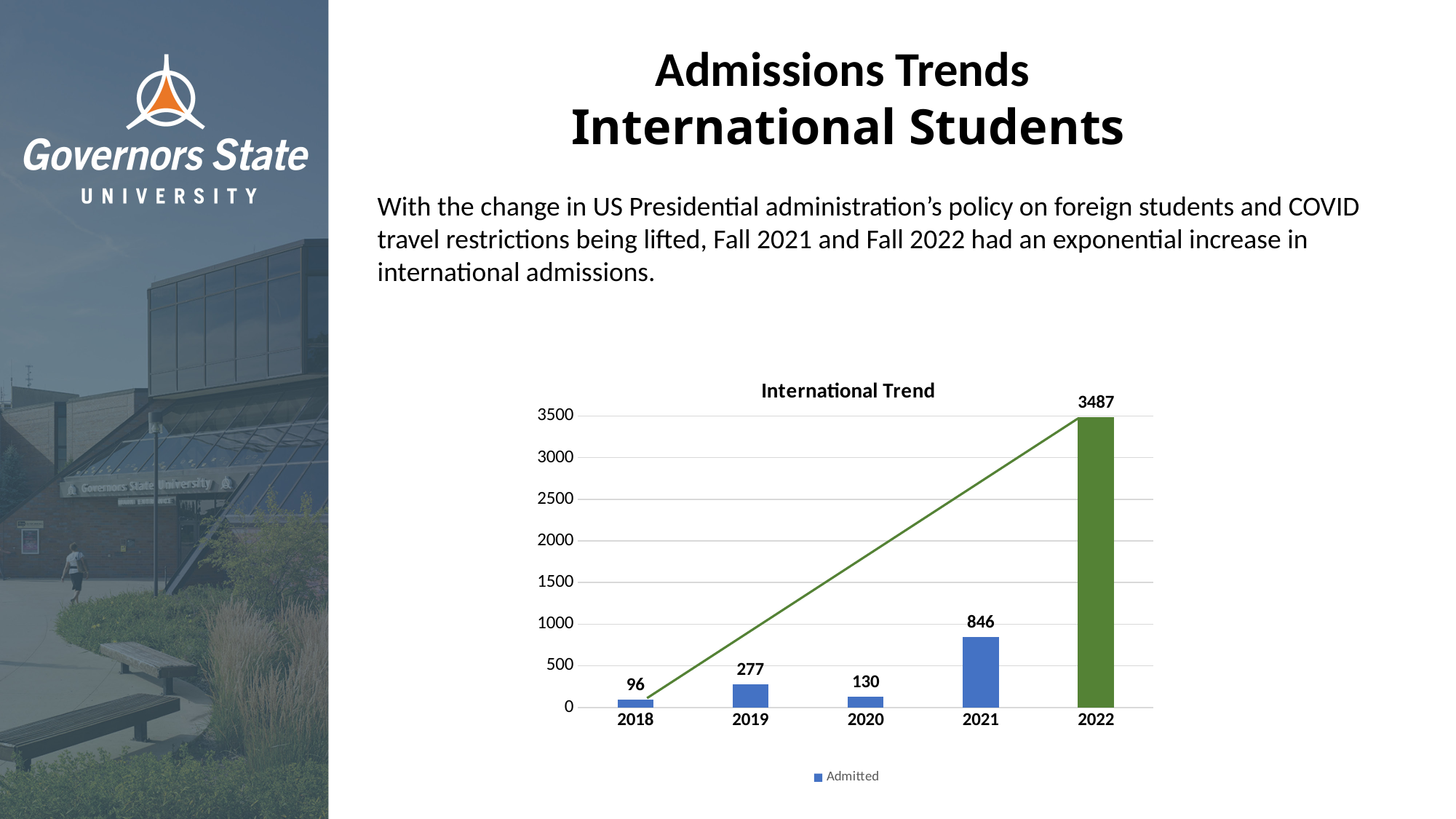
Which year has the highest value in the International Trend chart? 2022 What is the difference between the values for 2022 and 2021 in the International Trend chart? 2641 What is the value for 2019 in the International Trend chart? 277 How many years are shown on the x axis of the International Trend chart? 5 What series name does the legend of the International Trend chart show? Admitted What is the value for 2022 in the International Trend chart? 3487 What kind of chart is the International Trend chart? bar chart What is the value for 2020 in the International Trend chart? 130 Is the value for 2021 in the International Trend chart greater or less than 1000? less What is the difference between the values for 2019 and 2020 in the International Trend chart? 147 Which year has the lowest value in the International Trend chart? 2018 Which is larger in the International Trend chart, the value for 2019 or the value for 2020? 2019